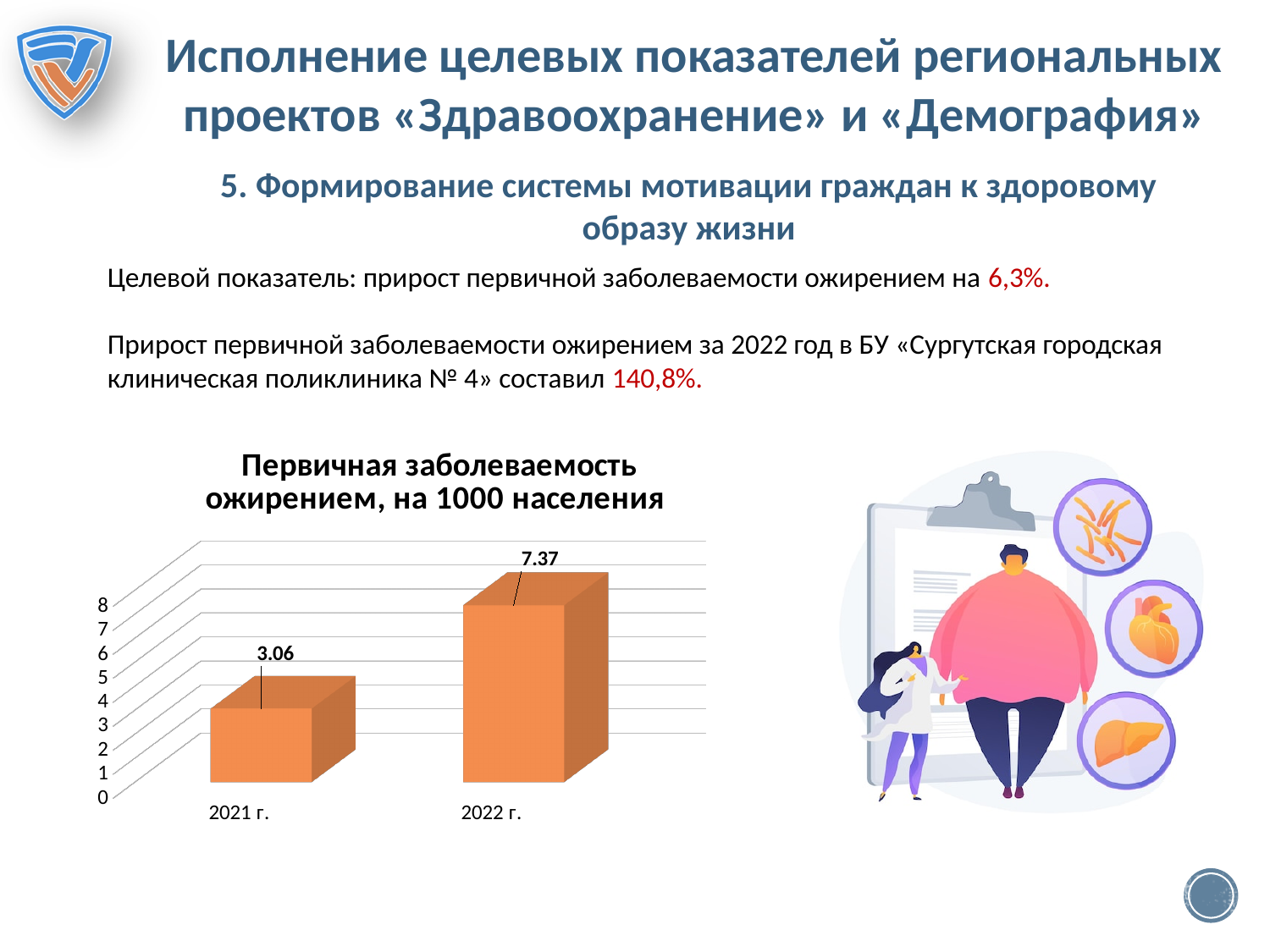
What is the difference between the 2022 г. and 2021 г. values? 4.31 What is the value for 2021 г. in the chart? 3.06 What is the value for 2022 г. in the chart? 7.37 How many categories are shown on the x axis of the chart? 2 Which year has the lower value in the chart? 2021 г. Is the value for 2021 г. greater or less than 4? less Do the values rise or fall from 2021 г. to 2022 г.? Rise What is the title of the chart? Первичная заболеваемость ожирением, на 1000 населения What kind of chart is shown on the slide? Bar chart Which year has the higher value in the chart? 2022 г. Is the value for 2022 г. larger than the value for 2021 г.? Yes Is the value for 2022 г. greater or less than 6? greater